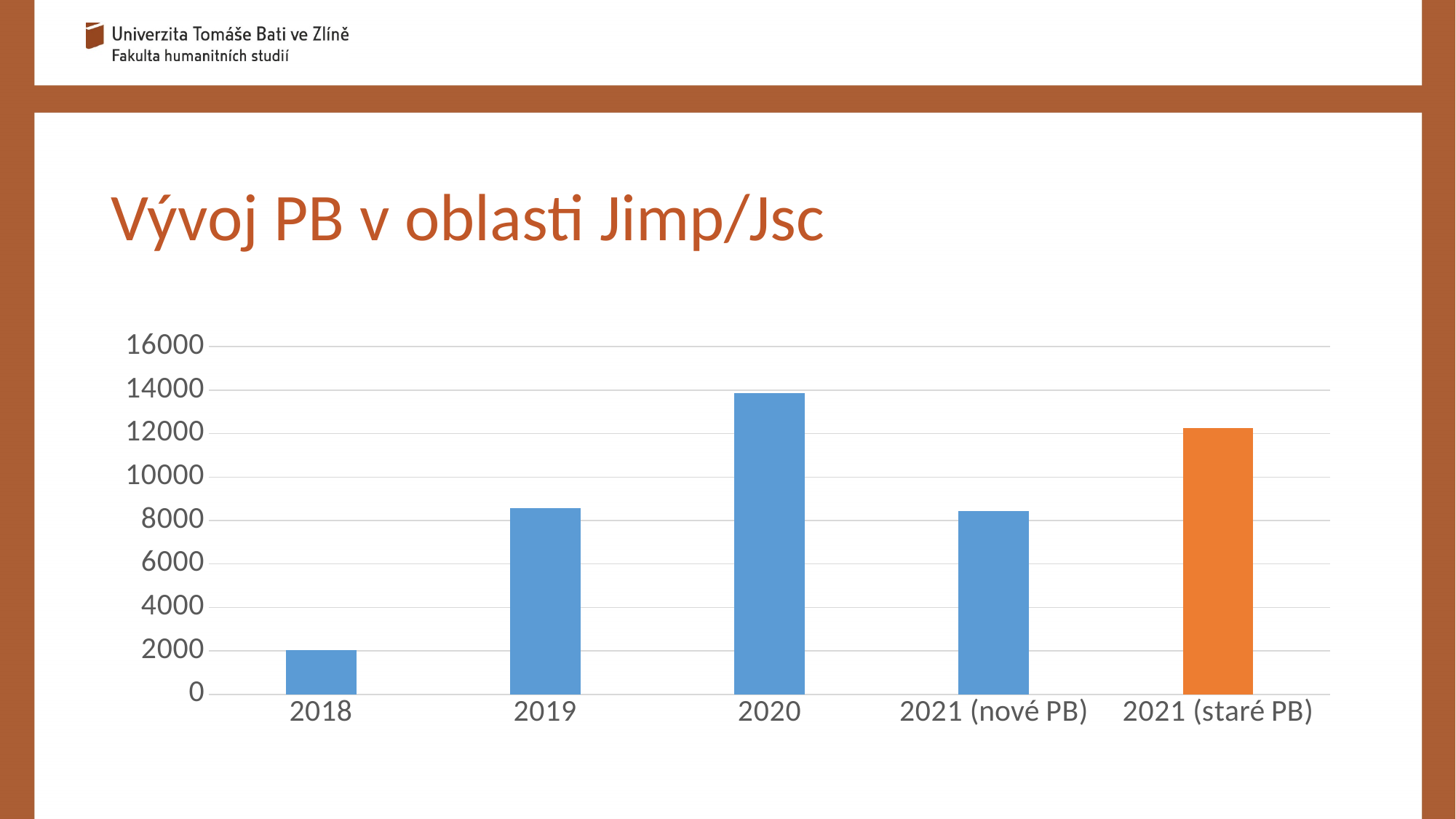
Is the value for 2021 (staré PB) greater or less than 14000? less Which category has the lowest bar in the chart? 2018 What kind of chart is shown on the slide? bar chart Which is larger, the value for 2021 (nové PB) or the value for 2021 (staré PB)? 2021 (staré PB) Which is larger, the value for 2020 or the value for 2021 (staré PB)? 2020 Is the value for 2021 (nové PB) greater or less than 6000? greater Do the values rise or fall from 2018 to 2020? rise What is the title of the slide containing the chart? Vývoj PB v oblasti Jimp/Jsc Is the value for 2019 greater or less than 8000? greater How many categories are shown on the x axis of the chart? 5 Which category has the highest bar in the chart? 2020